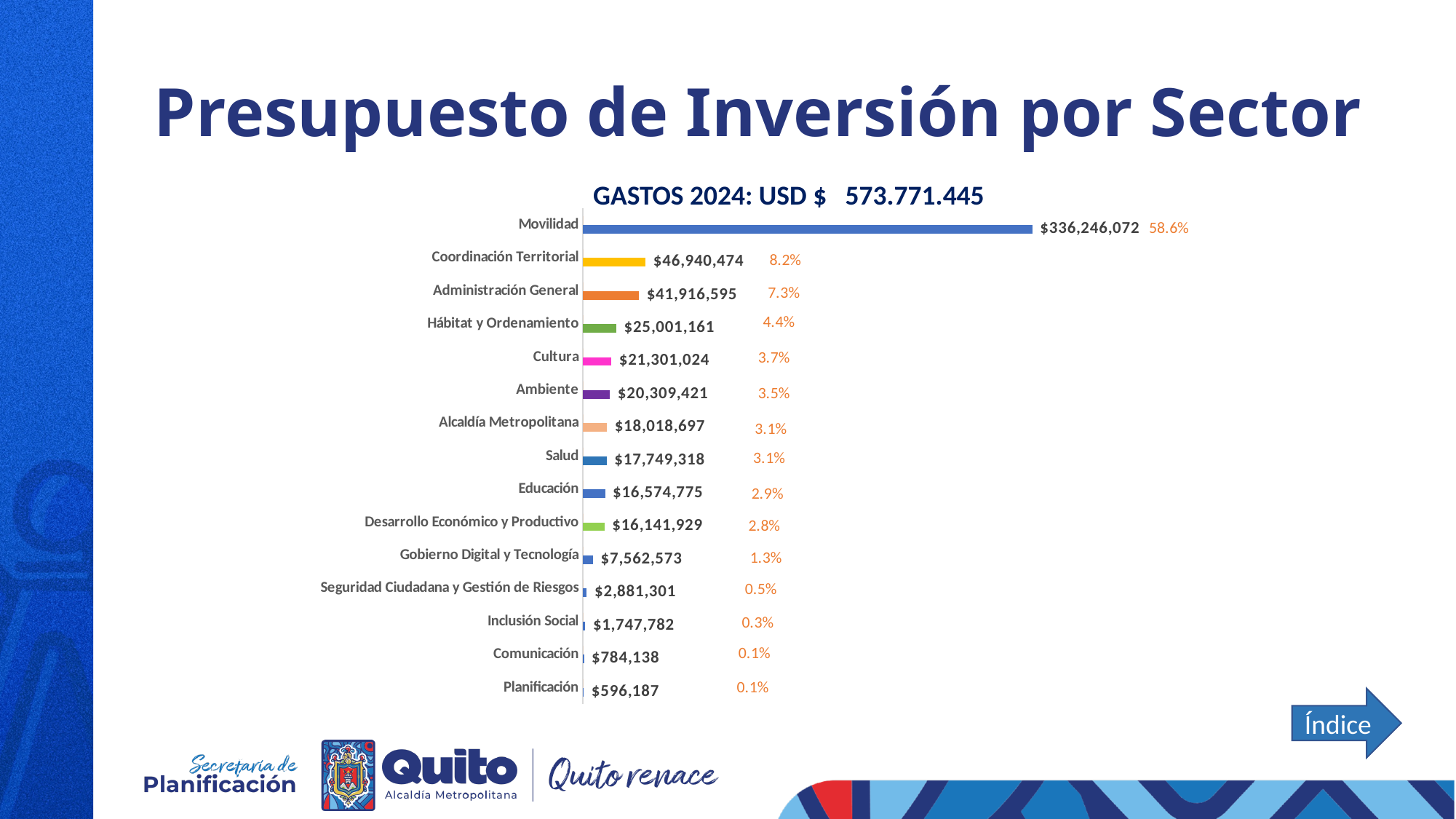
What percentage share is shown for Coordinación Territorial? 8.2% What is the title of the chart? GASTOS 2024: USD $ 573.771.445 What is the difference between the values for Coordinación Territorial and Administración General? $5,023,879 Which sector has the highest value? Movilidad What is the value for Movilidad? $336,246,072 What kind of chart is shown on the slide? Bar chart Which is larger, the value for Hábitat y Ordenamiento or the value for Cultura? Hábitat y Ordenamiento What is the value for Salud? $17,749,318 How many sectors are shown in the chart? 15 Do the values rise or fall going from the top bar to the bottom bar? Fall Which sector has the lowest value? Planificación What is the difference between the values for Cultura and Ambiente? $991,603